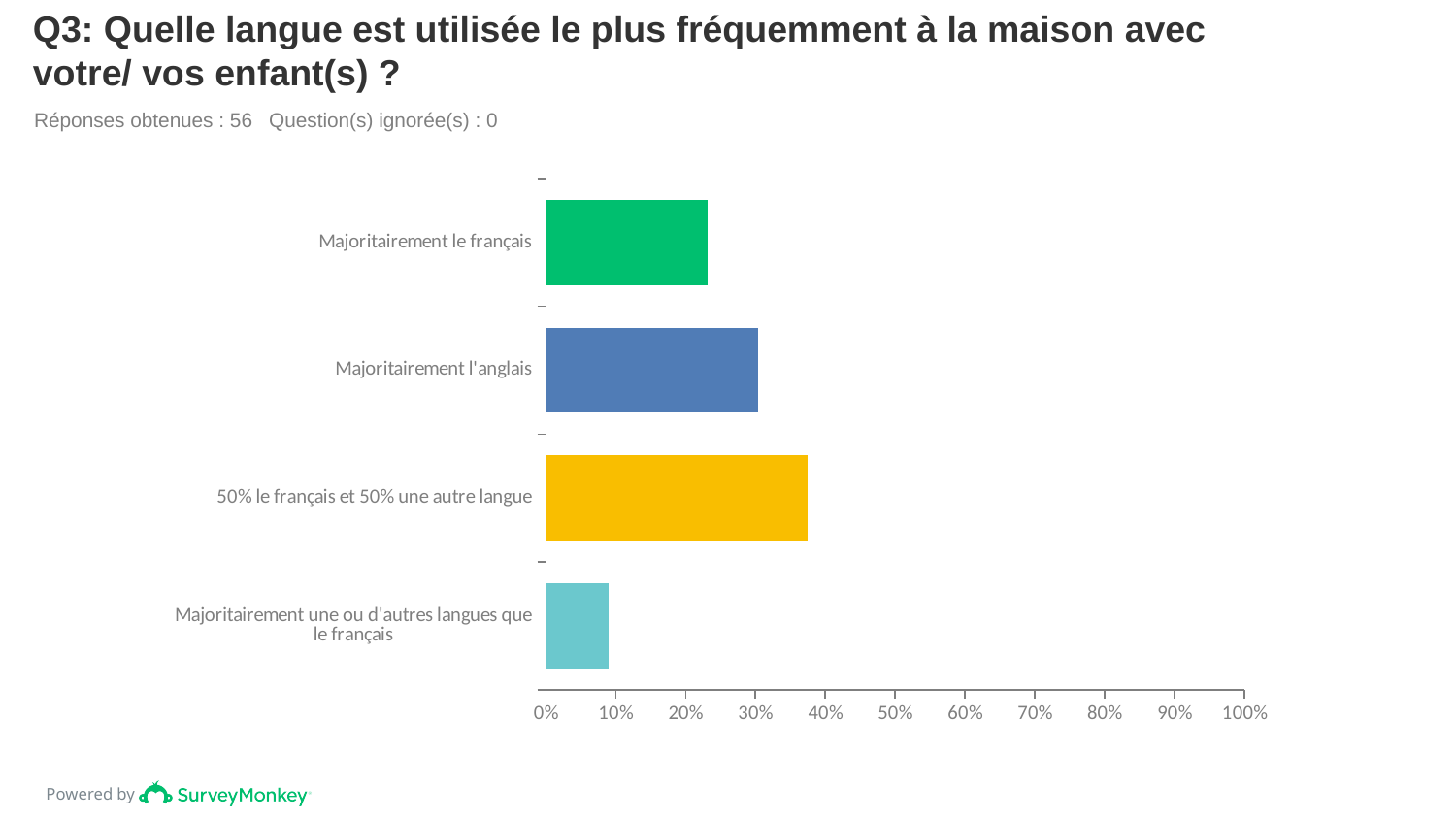
Which is larger: the value for "50% le français et 50% une autre langue" or the value for "Majoritairement l'anglais"? 50% le français et 50% une autre langue How many responses were obtained for this question, according to the slide? 56 Which is larger: the value for "Majoritairement l'anglais" or the value for "Majoritairement le français"? Majoritairement l'anglais Which category has the lowest value? Majoritairement une ou d'autres langues que le français Is the value for "Majoritairement une ou d'autres langues que le français" greater or less than 20%? less Is the value for "Majoritairement le français" greater or less than 30%? less What is the maximum value shown on the horizontal axis of the chart? 100% What kind of chart is shown on the slide? Bar chart How many categories are shown in the chart? 4 Is the value for "Majoritairement le français" greater or less than 20%? greater Which category has the highest value? 50% le français et 50% une autre langue